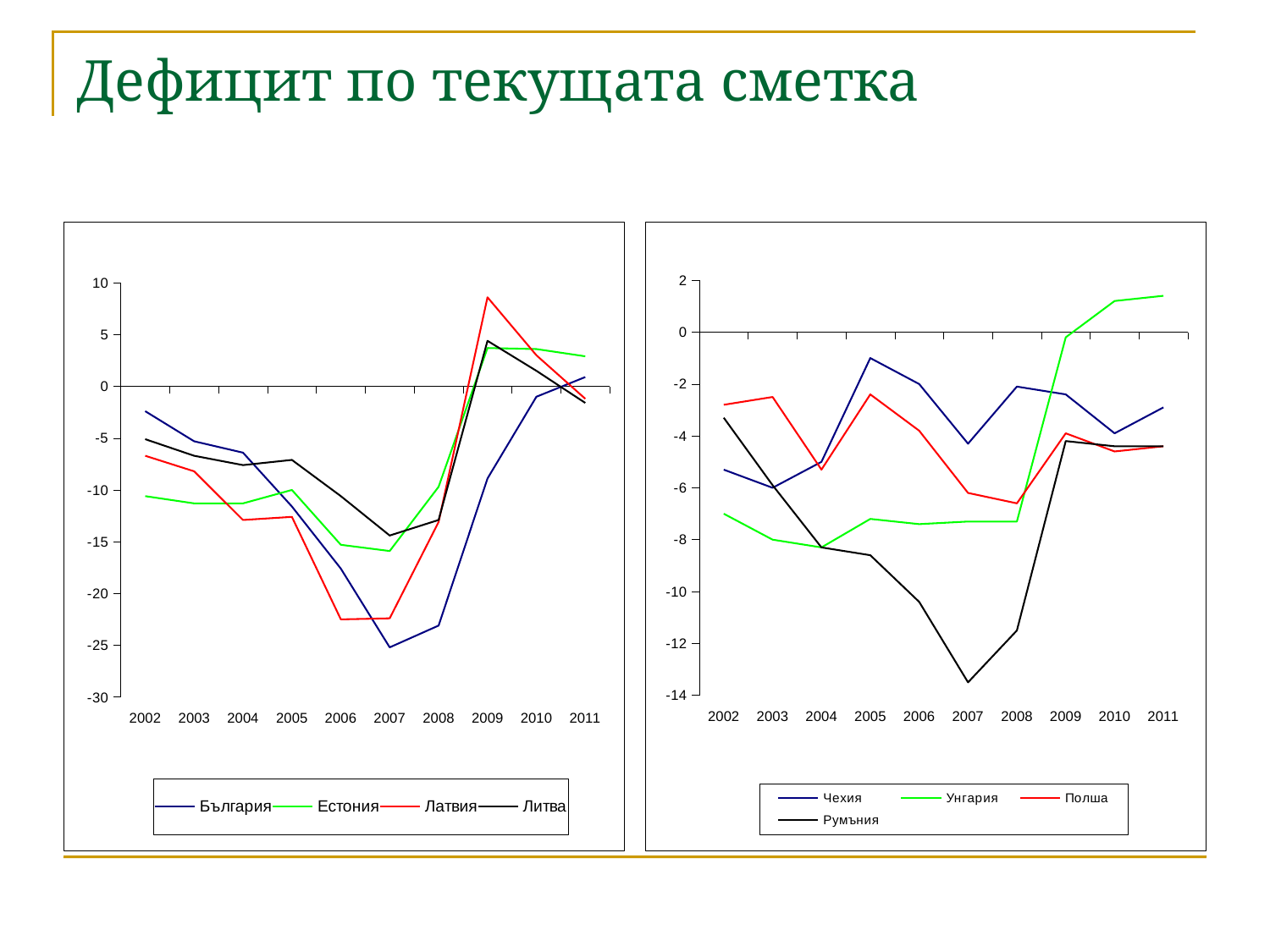
In the left chart, is the value for Латвия in 2009 greater or less than 5? greater In the left chart, which series has the lowest value in 2007? България How many series does the legend of the right chart list? 4 In the right chart, is the value for Румъния in 2007 greater or less than -12? less In the right chart, which series has the highest value in 2011? Унгария In the left chart, is the value for България in 2007 greater or less than -20? less In the right chart, does the line for Унгария rise or fall from 2008 to 2011? rise In the left chart, does the line for България rise or fall from 2002 to 2007? fall In the left chart, which series has the highest value in 2009? Латвия What kind of chart is the left chart on the slide? line chart How many years are shown on the x axis of the left chart? 10 In the right chart, which series has the lowest value in 2007? Румъния